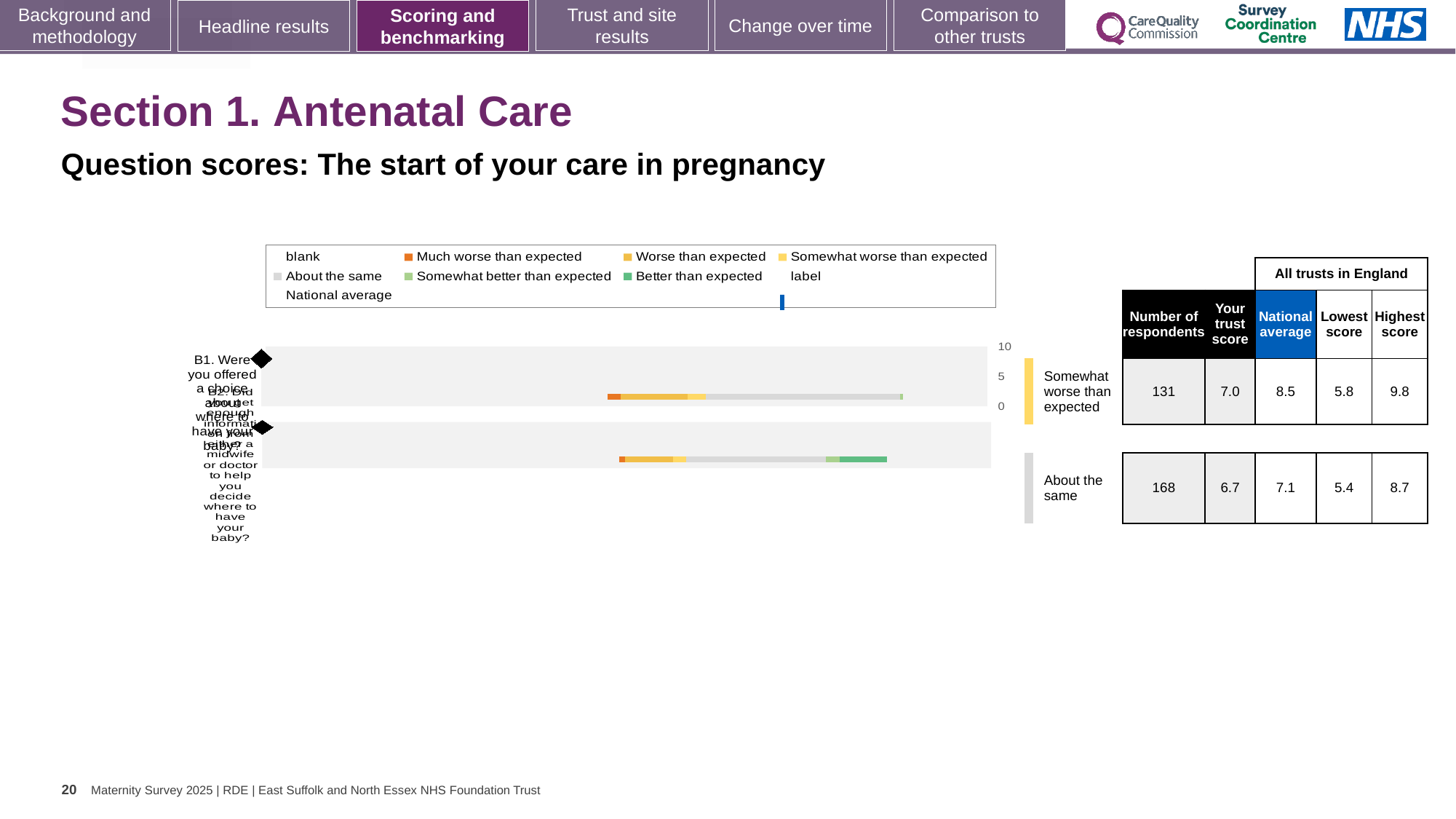
What is the lowest score among all trusts in England for question B2? 5.4 What is the 'Your trust score' value for question B2? 6.7 What is the difference between the national average and the trust score for question B1? 1.5 What kind of chart is used to show the question scores? Bar chart How many respondents are shown for question B2? 168 Which benchmark category is question B1 placed in? Somewhat worse than expected What is the national average score for question B1? 8.5 Which benchmark category is question B2 placed in? About the same How many respondents are shown for question B1 in the table? 131 Which question has more respondents, B1 or B2? B2 What is the 'Your trust score' value for question B1? 7.0 What is the highest score among all trusts in England for question B1? 9.8